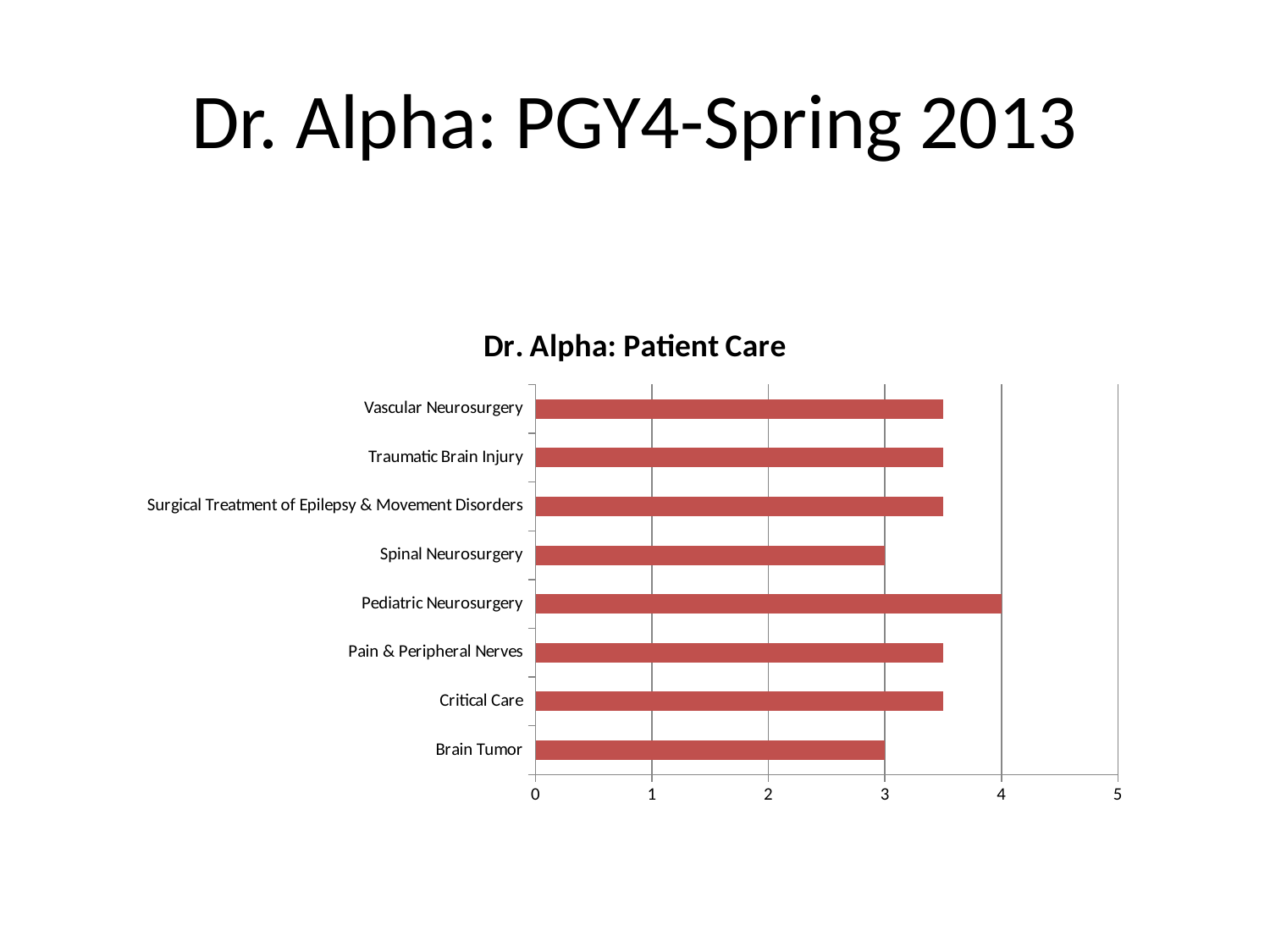
What is the value for Pediatric Neurosurgery? 4 How many categories are plotted in the chart? 8 Is the value for Vascular Neurosurgery greater or less than 3? greater Is the value for Traumatic Brain Injury greater or less than 4? less What is the title of the chart? Dr. Alpha: Patient Care What is the difference between the values for Pediatric Neurosurgery and Brain Tumor? 1 Is the value for Critical Care greater or less than 4? less What is the value for Spinal Neurosurgery? 3 What kind of chart is shown on the slide? bar chart Which is larger, the value for Pediatric Neurosurgery or the value for Spinal Neurosurgery? Pediatric Neurosurgery What is the value for Brain Tumor? 3 Which category has the highest value? Pediatric Neurosurgery